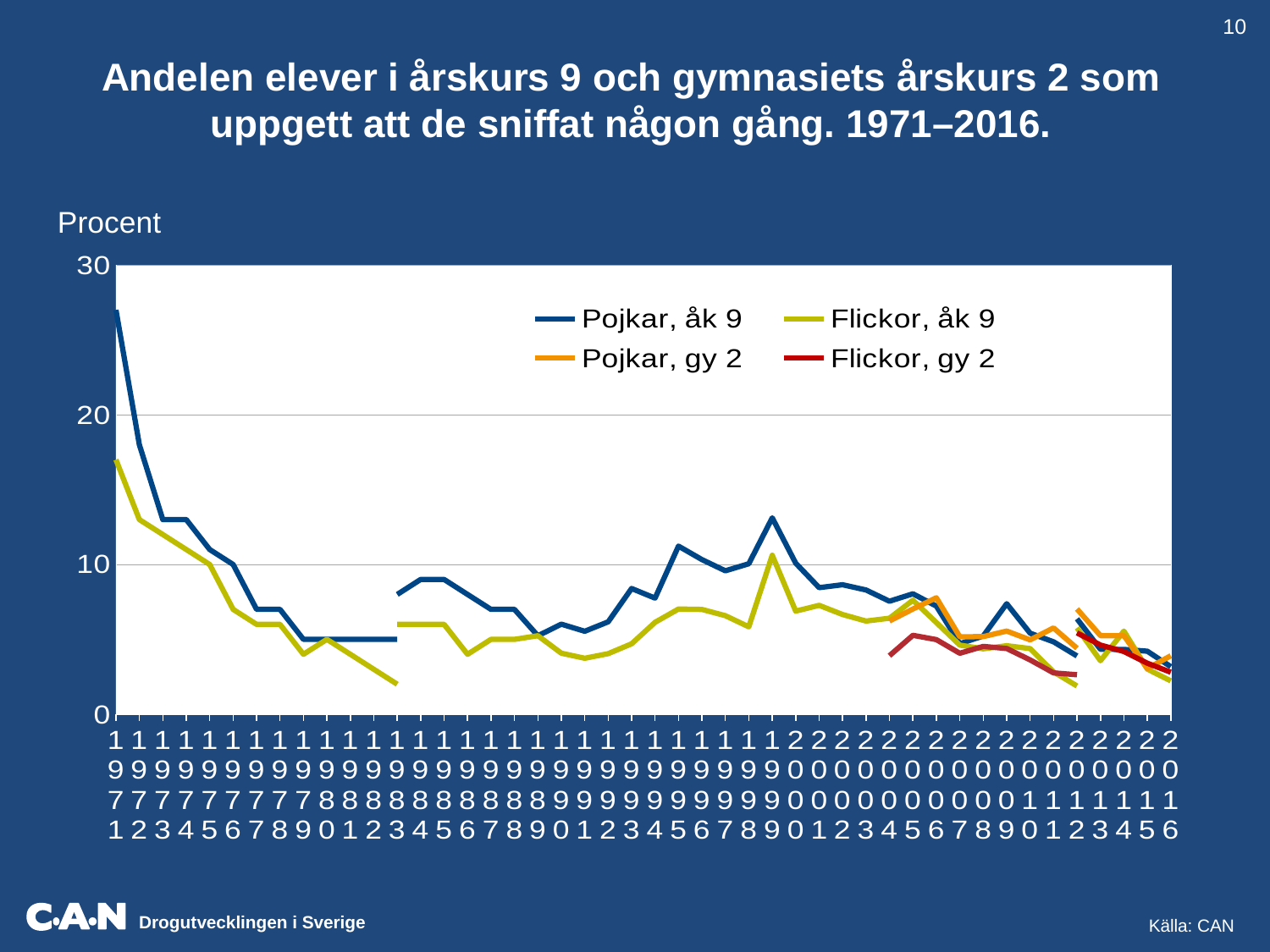
How many series does the legend list? 4 Is the value for Flickor, åk 9 in 1971 greater or less than 20? less Is the value for Pojkar, åk 9 in 1982 greater or less than 10? less Is the value for Pojkar, åk 9 in 1971 greater or less than 20? greater Which series has the highest value in 1971? Pojkar, åk 9 What label is shown above the vertical axis? Procent Overall, does the Pojkar, åk 9 line rise or fall from 1971 to 2016? fall What kind of chart is shown on the slide? line chart In 1971, which series has the higher value, Pojkar, åk 9 or Flickor, åk 9? Pojkar, åk 9 What are the four series named in the legend? Pojkar, åk 9; Pojkar, gy 2; Flickor, åk 9; Flickor, gy 2